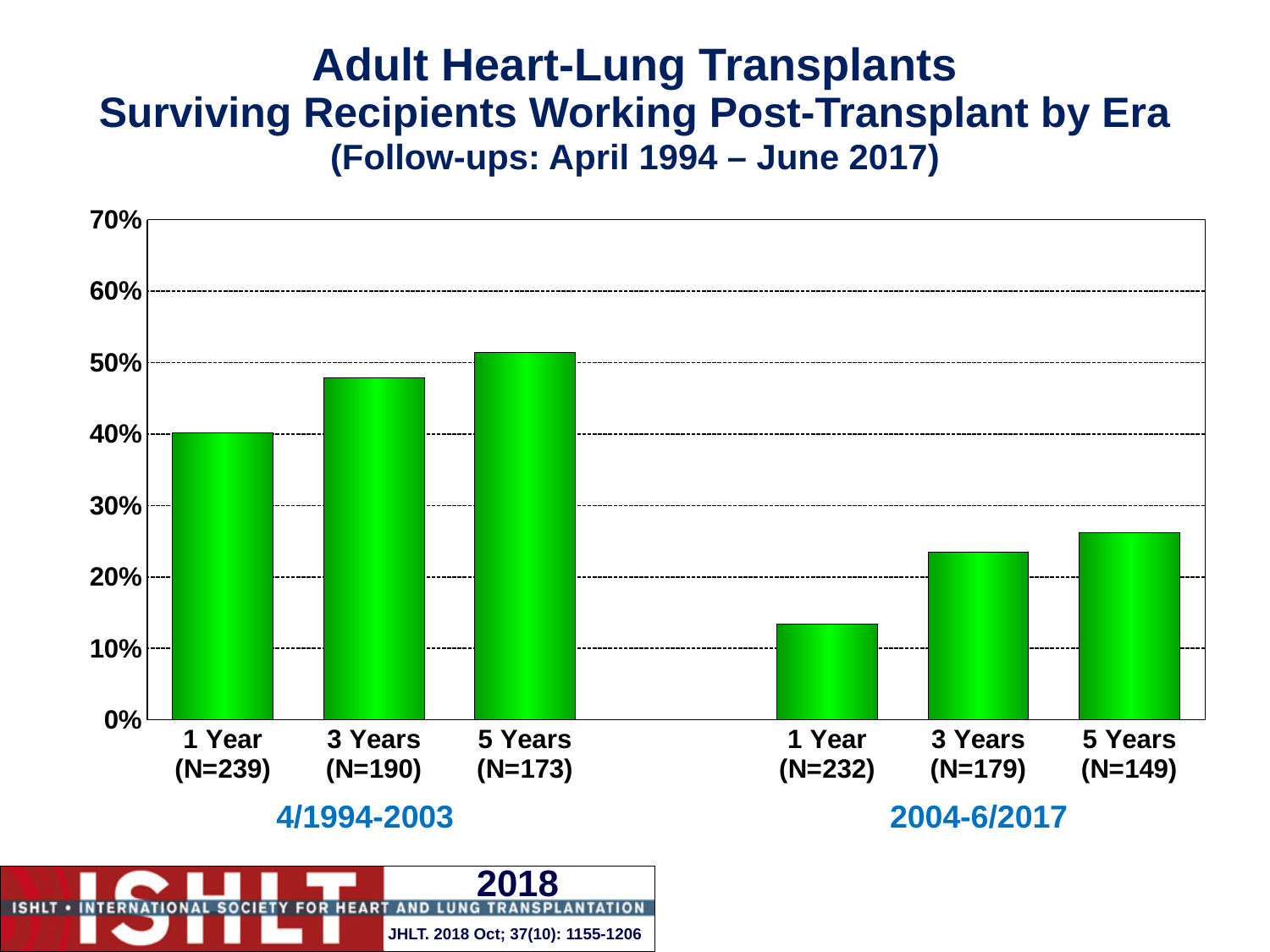
What is the N shown for the 5 Years bar in the 2004-6/2017 era? N=149 Is the value for 5 Years (N=149) in the 2004-6/2017 era greater or less than 30%? less Within the 2004-6/2017 era, do the values rise or fall from 1 Year to 5 Years? rise What kind of chart is shown on the slide? bar chart Which is larger: the value for 3 Years in the 4/1994-2003 era or the value for 3 Years in the 2004-6/2017 era? 3 Years in the 4/1994-2003 era Is the value for 3 Years (N=190) in the 4/1994-2003 era greater or less than 40%? greater What are the two eras labelled beneath the chart? 4/1994-2003 and 2004-6/2017 Is the value for 1 Year (N=232) in the 2004-6/2017 era greater or less than 20%? less How many bars are plotted in the chart? 6 Which bar has the lowest value in the chart? 1 Year (N=232), 2004-6/2017 Which bar has the highest value in the chart? 5 Years (N=173), 4/1994-2003